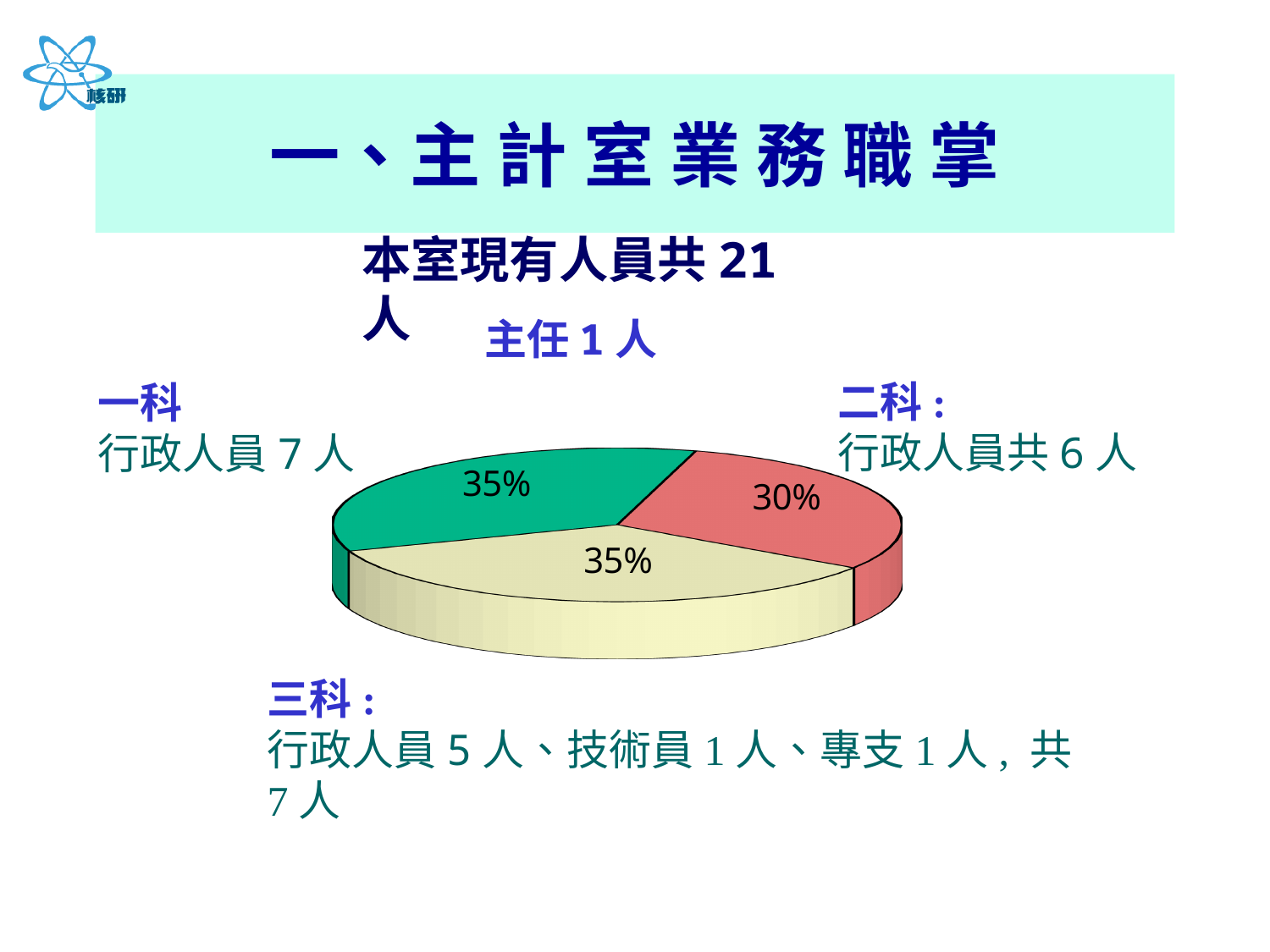
What is the combined percentage of the green and cream slices? 70% What is the difference in percentage points between the green slice and the red slice? 5 Which slice of the pie chart is the smallest? the red slice (30%) What kind of chart is shown on the slide? pie chart What percentage is shown on the red slice of the pie chart? 30% Is the pie chart drawn in 3D or flat 2D? 3D Do the green and cream slices of the pie chart show the same percentage? yes, both 35% Is the value of the red slice greater or less than 35%? less What percentage is shown on the cream-coloured slice of the pie chart? 35% How many slices does the pie chart have? 3 What percentage is shown on the green slice of the pie chart? 35% Which is larger in the pie chart, the green slice or the red slice? the green slice